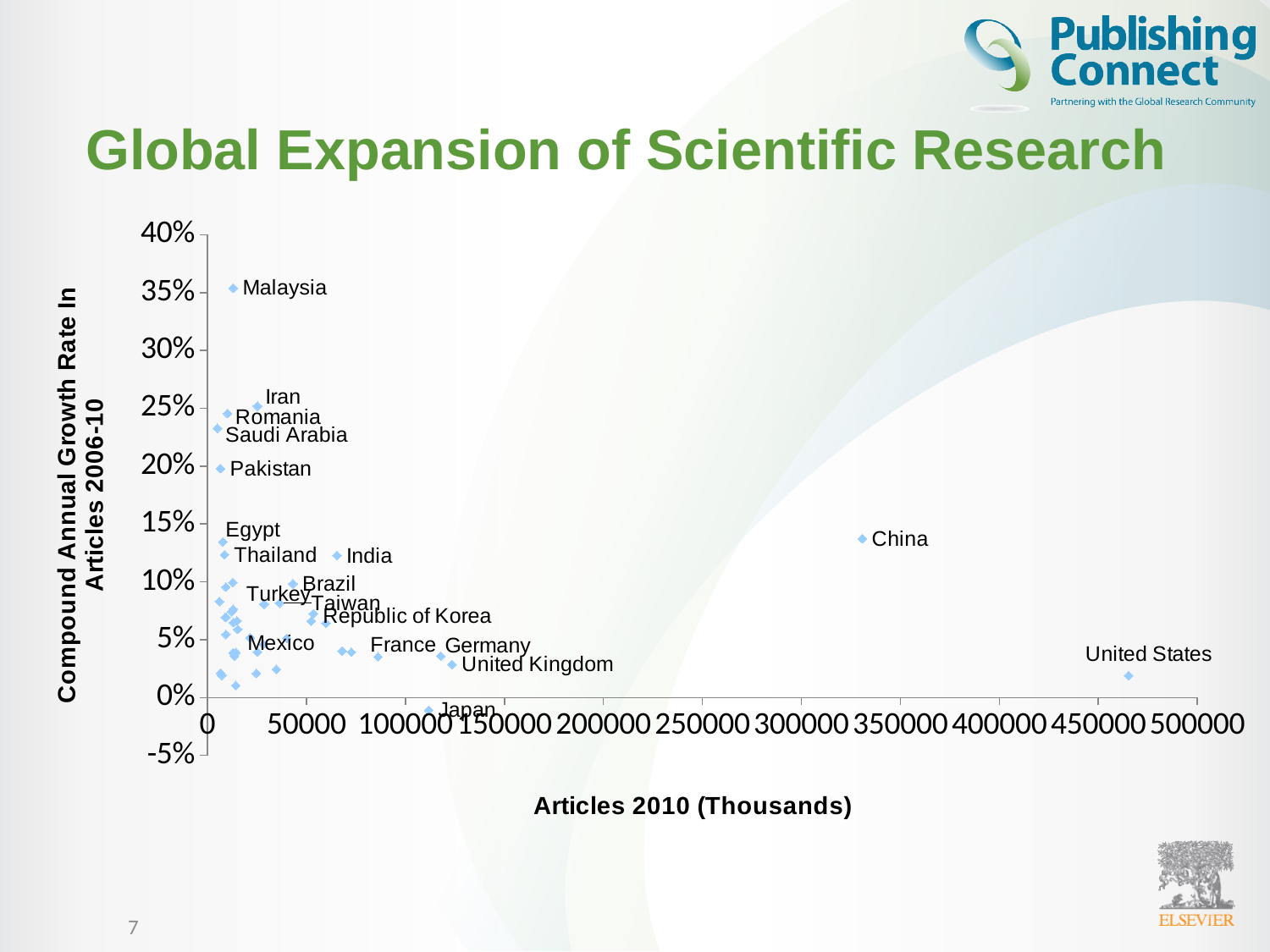
Is the compound annual growth rate for Pakistan greater or less than 15%? greater Which has more articles in 2010, China or the United States? United States What kind of chart is shown on the slide? scatter chart Is the number of articles in 2010 for the United States greater or less than 400000? greater Which has a higher compound annual growth rate, Malaysia or Iran? Malaysia Is the compound annual growth rate for Japan greater or less than 0%? less Which labelled country has the highest compound annual growth rate in articles 2006-10? Malaysia Which labelled country has the highest number of articles in 2010? United States What is the label of the horizontal axis? Articles 2010 (Thousands)